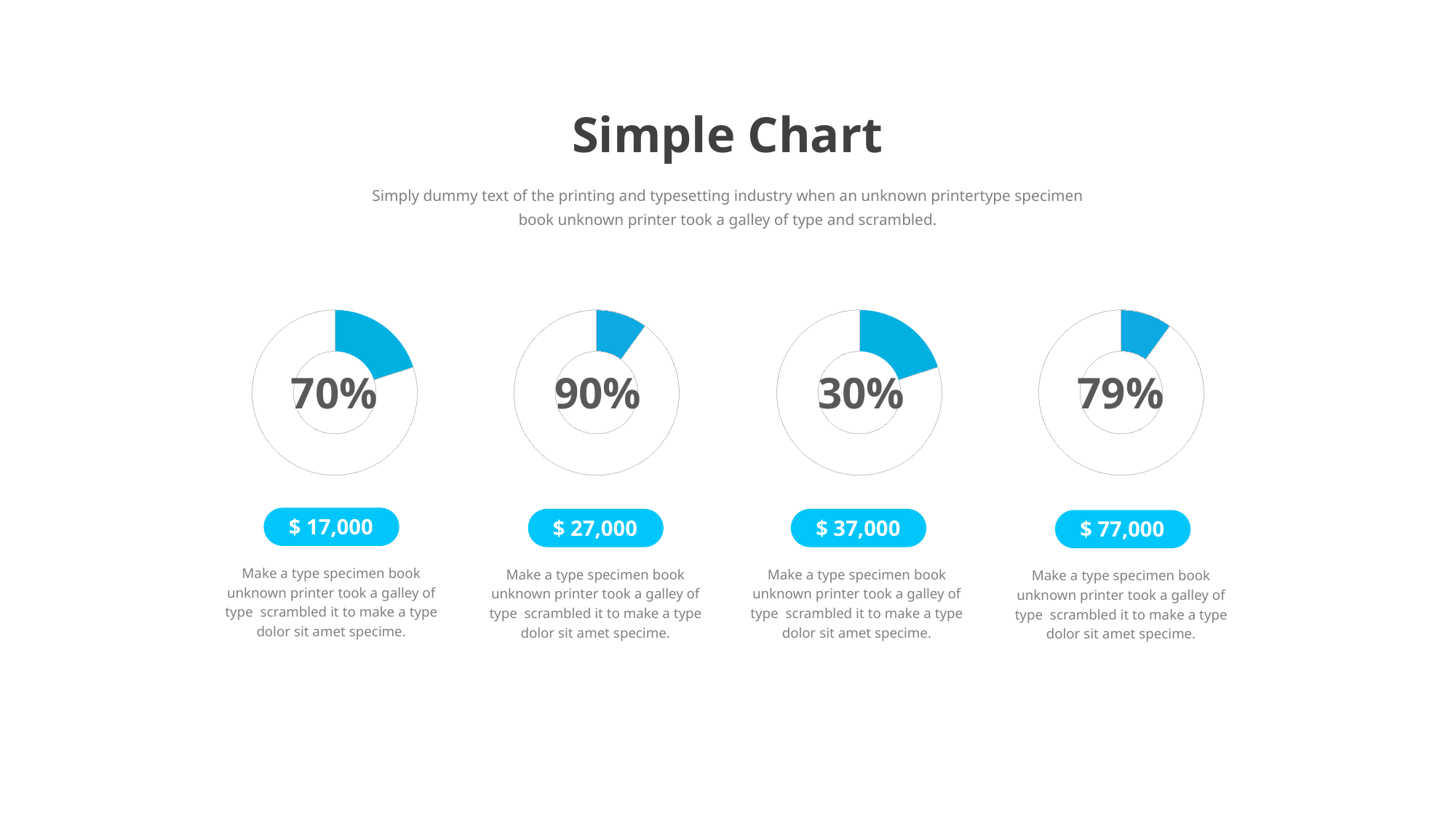
What dollar amount is labelled below the donut chart showing 30%? $ 37,000 What dollar amount is labelled below the donut chart showing 79%? $ 77,000 What is the difference between the percentages shown in the second and third donut charts from the left? 60% What percentage is shown in the centre of the second donut chart from the left? 90% Which donut chart shows the highest percentage, identified by its dollar label? $ 27,000 What is the title of the slide containing the donut charts? Simple Chart Which is larger, the percentage in the leftmost donut chart or the percentage in the rightmost donut chart? the rightmost (79%) What percentage is shown in the centre of the third donut chart from the left? 30% Which donut chart shows the lowest percentage, identified by its dollar label? $ 37,000 What percentage is shown in the centre of the leftmost donut chart? 70% How many donut charts are on the slide? 4 What percentage is shown in the centre of the rightmost donut chart? 79%